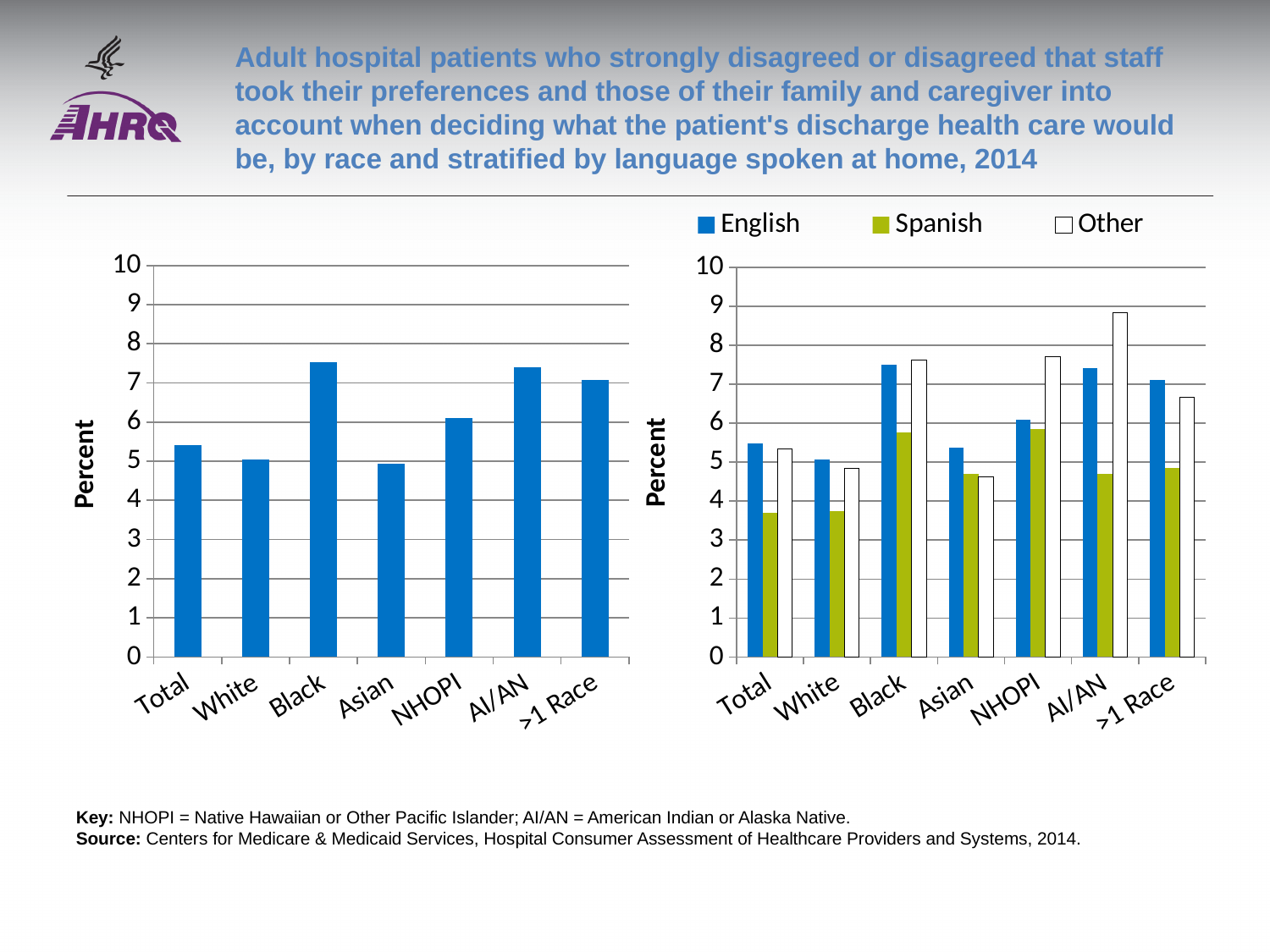
In the left chart, which is larger, the value for Black or the value for White? Black In the right chart, which is larger for White, the English value or the Spanish value? English What kind of chart is the left chart on the slide? bar chart In the right chart, is the Other value for NHOPI greater or less than 7? greater In the left chart, is the value for Black greater or less than 7? greater What is the label on the y axis of the right chart? Percent How many race categories are shown on the x axis of the left chart? 7 In the right chart, is the Spanish value for Total greater or less than 4? less In the right chart, which race category has the highest value for the Other series? AI/AN How many series does the legend of the right chart list? 3